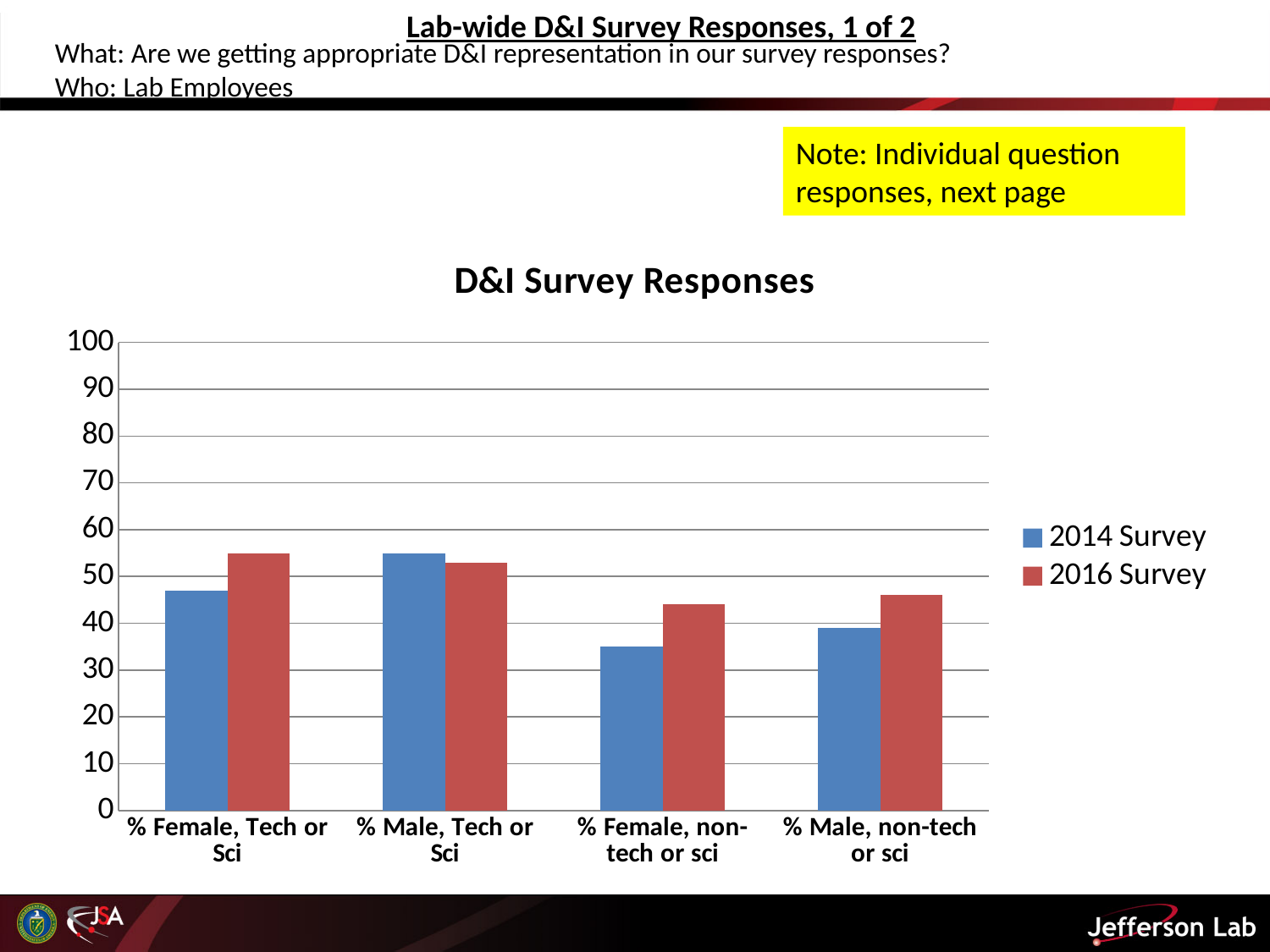
How many categories are shown on the x axis of the chart? 4 What is the title of the chart? D&I Survey Responses What kind of chart is shown on the slide? bar chart Which series is shown in red in the chart? 2016 Survey Is the 2016 Survey value for % Male, non-tech or sci greater or less than 50? less Which category has the lowest value for the 2014 Survey series? % Female, non-tech or sci For % Female, Tech or Sci, which survey has the larger value, 2014 Survey or 2016 Survey? 2016 Survey Is the 2014 Survey value for % Female, non-tech or sci greater or less than 40? less How many series does the chart's legend list? 2 Which category has the highest value for the 2014 Survey series? % Male, Tech or Sci For % Male, non-tech or sci, which survey has the larger value, 2014 Survey or 2016 Survey? 2016 Survey Is the 2016 Survey value for % Female, Tech or Sci greater or less than 50? greater